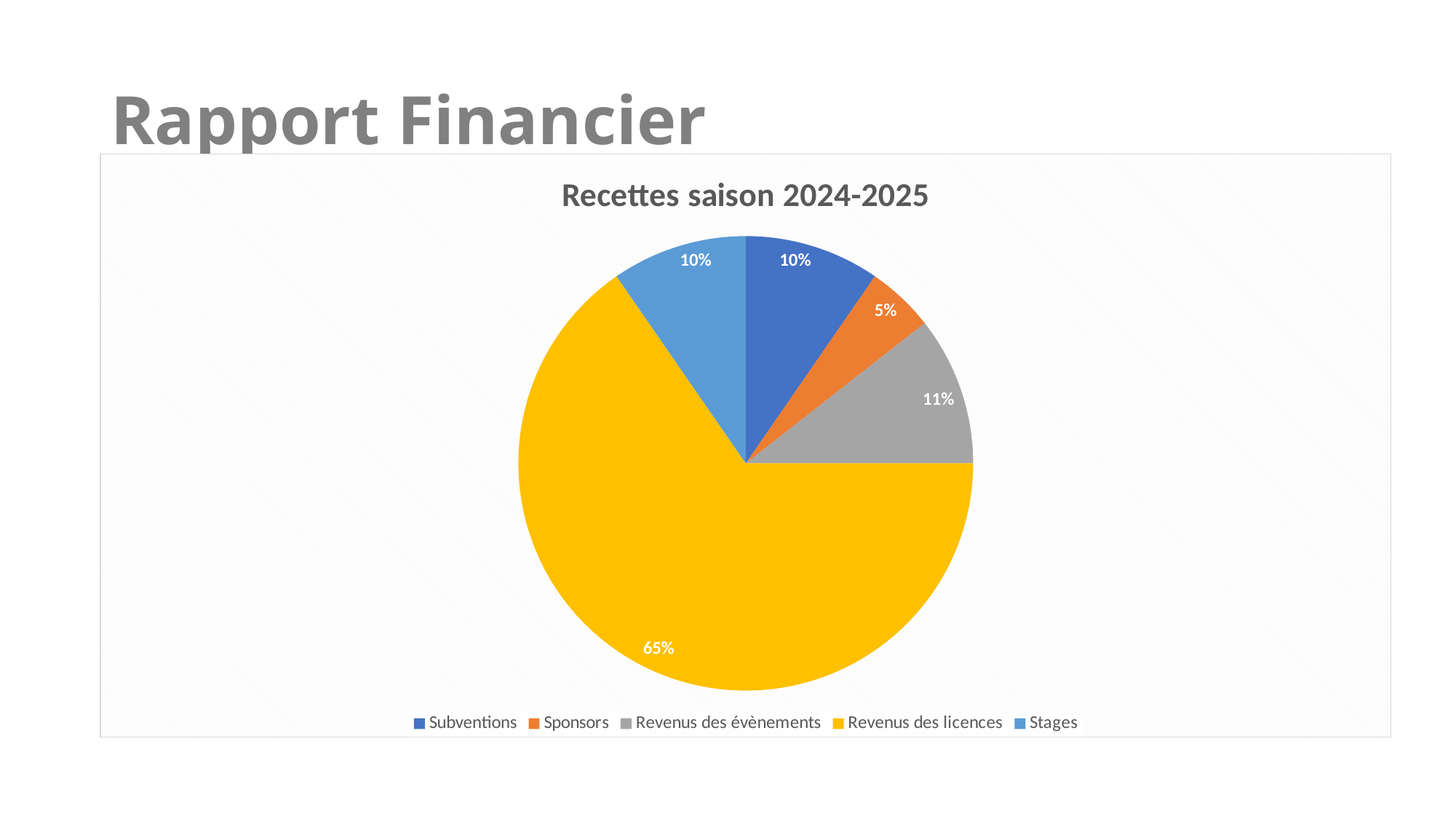
What is the title of the chart? Recettes saison 2024-2025 How many categories are shown in the pie chart? 5 Which category has the largest slice of the pie? Revenus des licences Which is larger, the share for Revenus des évènements or the share for Sponsors? Revenus des évènements What is the difference in percentage points between Revenus des licences and Revenus des évènements? 54 What share of the pie does Revenus des évènements represent? 11% What kind of chart is shown on the slide? Pie chart Which category has the smallest slice of the pie? Sponsors What share of the pie does Sponsors represent? 5% What share of the pie does Subventions represent? 10%